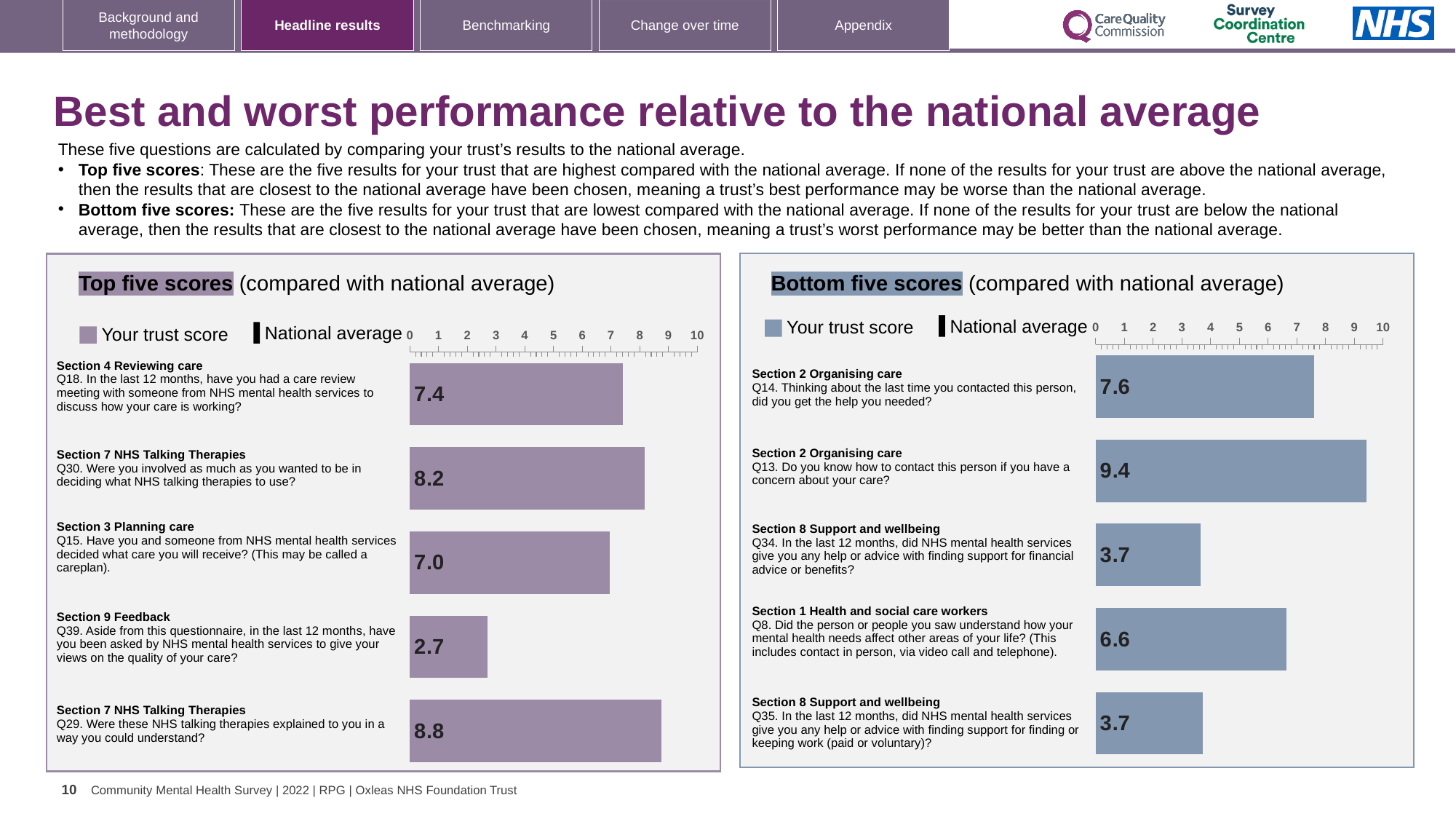
What type of chart is the Top five scores chart? Bar chart In the Bottom five scores chart, what is the trust score for Q8 (understanding how mental health needs affect other areas of your life)? 6.6 How many questions are plotted in the Bottom five scores chart? 5 In the Bottom five scores chart, what is the difference between the trust scores for Q13 and Q34? 5.7 In the Top five scores chart, what is the difference between the trust scores for Q30 and Q15? 1.2 In the Top five scores chart, what is the trust score for Q29 (NHS talking therapies explained in a way you could understand)? 8.8 In the Bottom five scores chart, which question has the highest trust score? Q13 In the Top five scores chart, what is the trust score for Q18 (care review meeting in the last 12 months)? 7.4 In the Bottom five scores chart, what is the trust score for Q13 (do you know how to contact this person if you have a concern)? 9.4 In the Top five scores chart, which question has the highest trust score? Q29 In the Bottom five scores chart, is the trust score for Q14 or Q8 larger? Q14 In the Top five scores chart, which question has the lowest trust score? Q39